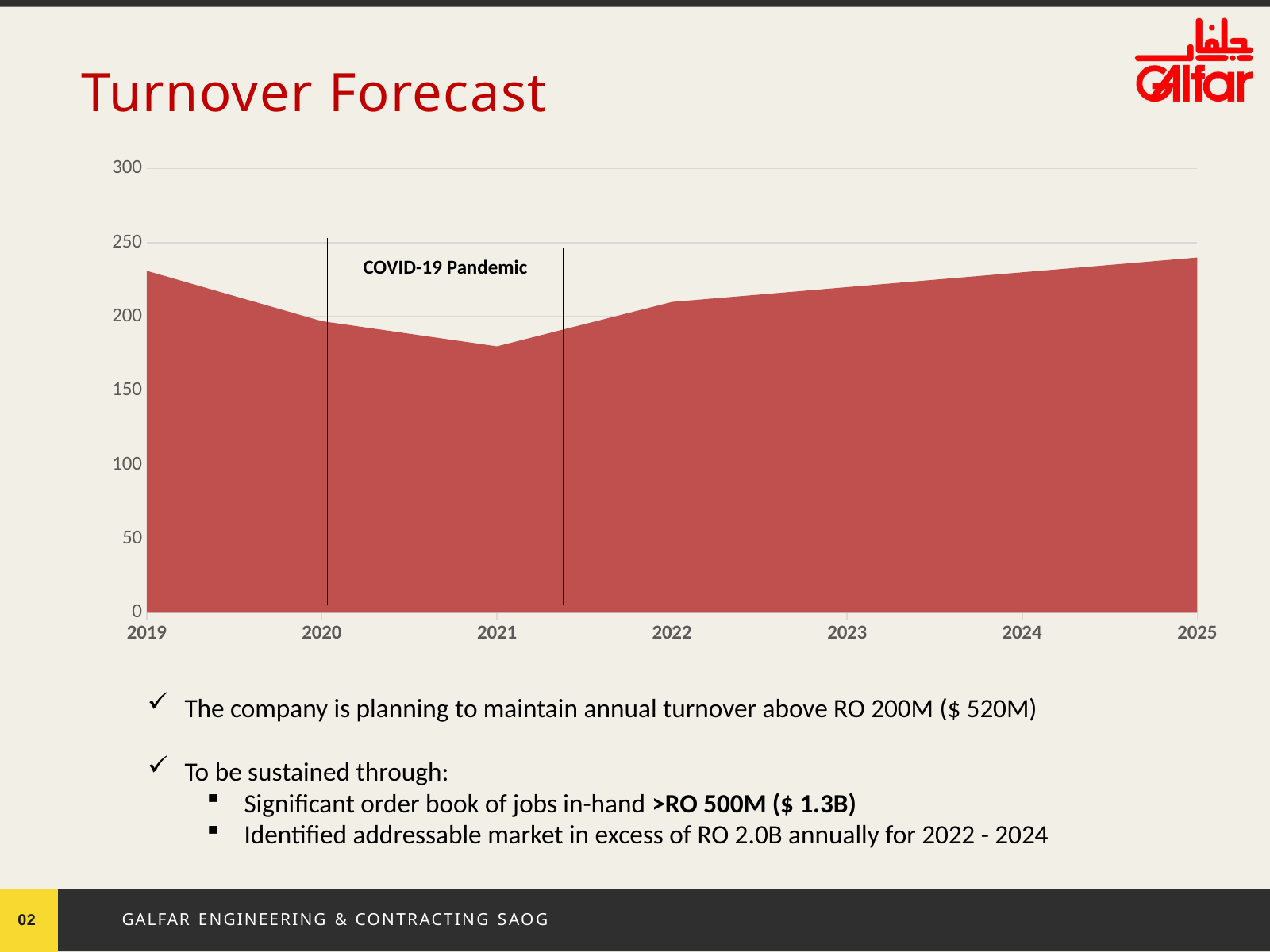
Is the value for 2019 greater or less than 200? greater Which year has the lowest turnover value in the chart? 2021 Do the values rise or fall from 2019 to 2021? fall Is the value for 2021 greater or less than 200? less What event is labelled between the two vertical lines on the chart? COVID-19 Pandemic Do the values rise or fall from 2021 to 2025? rise Is the value for 2025 greater or less than 250? less What kind of chart is shown on the slide? Area chart What is the title of the chart on the slide? Turnover Forecast Which year has the highest turnover value in the chart? 2025 How many years are shown on the x axis of the chart? 7